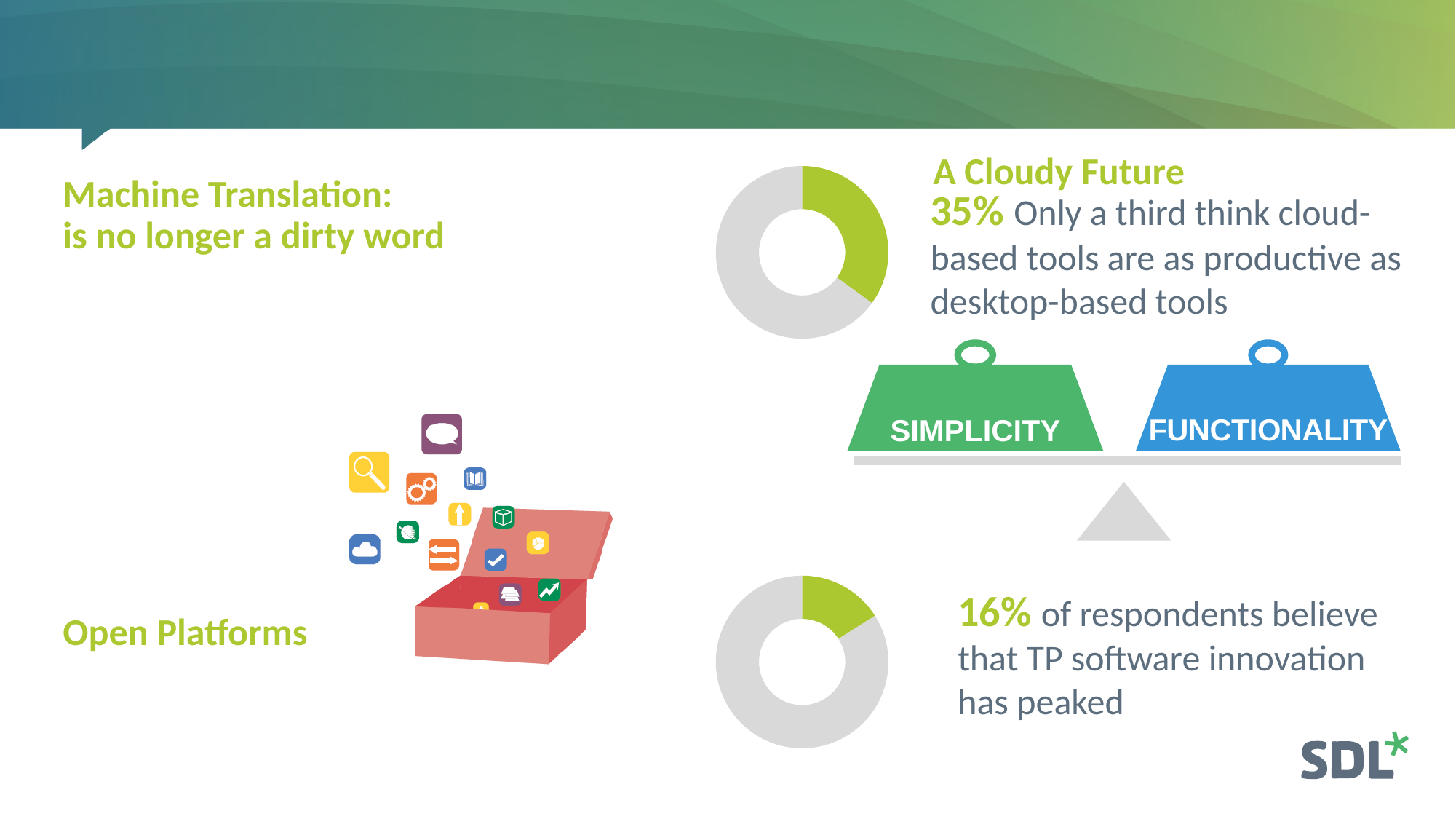
What is the difference between the highlighted share in the top donut chart (35%) and the bottom donut chart (16%)? 19 percentage points Which donut chart shows the larger highlighted share: the top one (cloud-based tools) or the bottom one (TP software innovation has peaked)? The top one (35%) In the top donut chart, what share of the ring is not highlighted in green? 65% How many segments does each donut chart on the slide have? 2 What kind of chart is shown next to the text 'A Cloudy Future'? Donut (pie) chart In the bottom donut chart, what share of the ring is grey (not highlighted)? 84% What is the title printed above the top donut chart's description? A Cloudy Future In the bottom donut chart, what percentage of respondents believe that TP software innovation has peaked? 16% Is the highlighted value in the top donut chart greater or less than 50%? less Is the highlighted value in the bottom donut chart greater or less than 25%? less What colour is used for the highlighted segment in both donut charts? Green In the top donut chart (A Cloudy Future), what percentage is highlighted in green? 35%